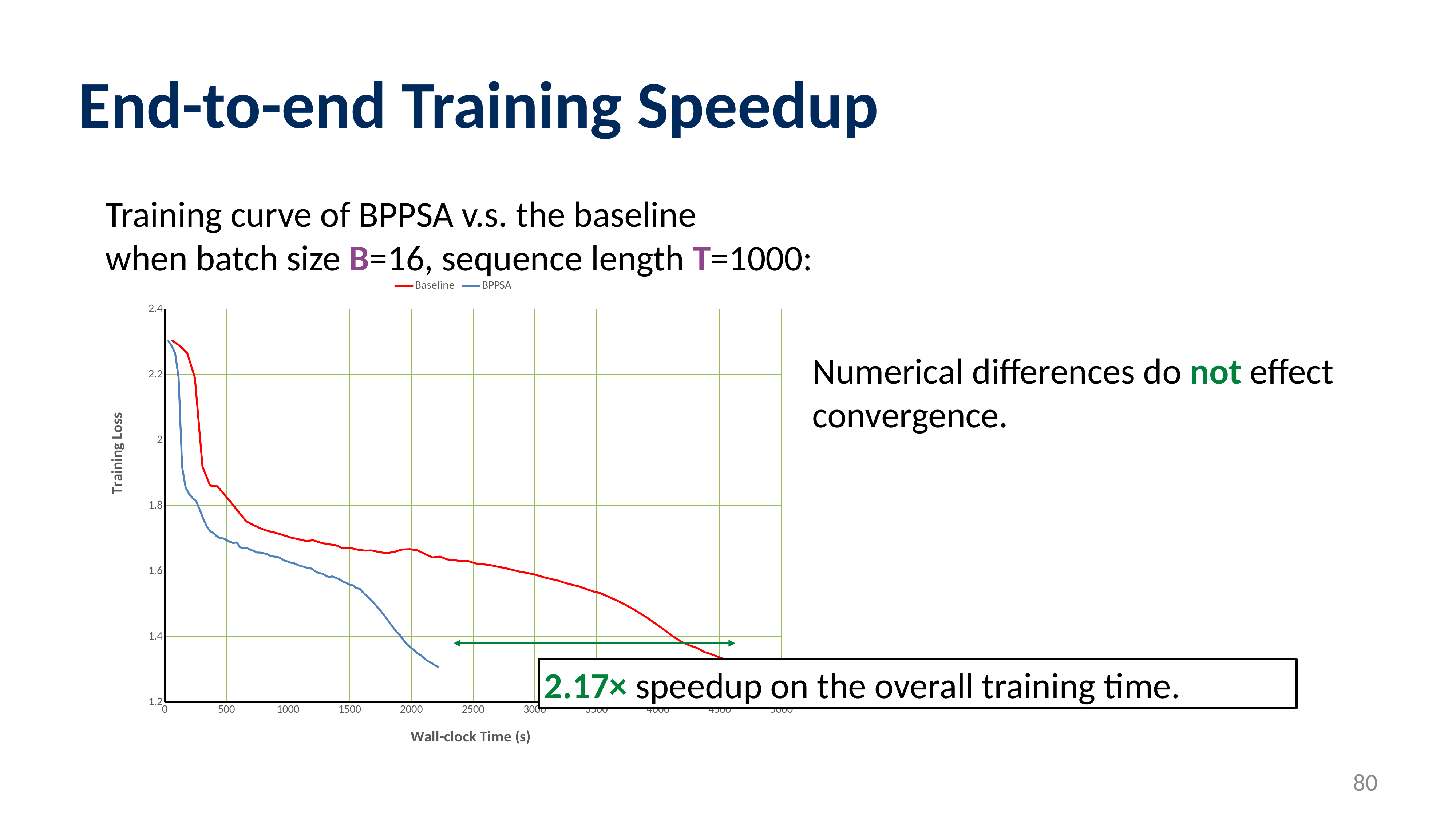
Does the training loss for the Baseline series rise or fall as wall-clock time increases? fall Is the training loss of the BPPSA series at a wall-clock time of 1000 s greater or less than 1.8? less Is the training loss of the Baseline series at a wall-clock time of 4000 s greater or less than 1.6? less Which series reaches the end of its training curve at a smaller wall-clock time, Baseline or BPPSA? BPPSA Does the training loss for the BPPSA series rise or fall as wall-clock time increases? fall Is the wall-clock time at which the Baseline curve ends greater or less than 4000? greater What is the label of the chart's x axis? Wall-clock Time (s) What kind of chart is shown on the slide? line chart Which two series are listed in the chart's legend? Baseline and BPPSA How many series does the chart's legend list? 2 At a wall-clock time of 1500 s, which series has the higher training loss, Baseline or BPPSA? Baseline